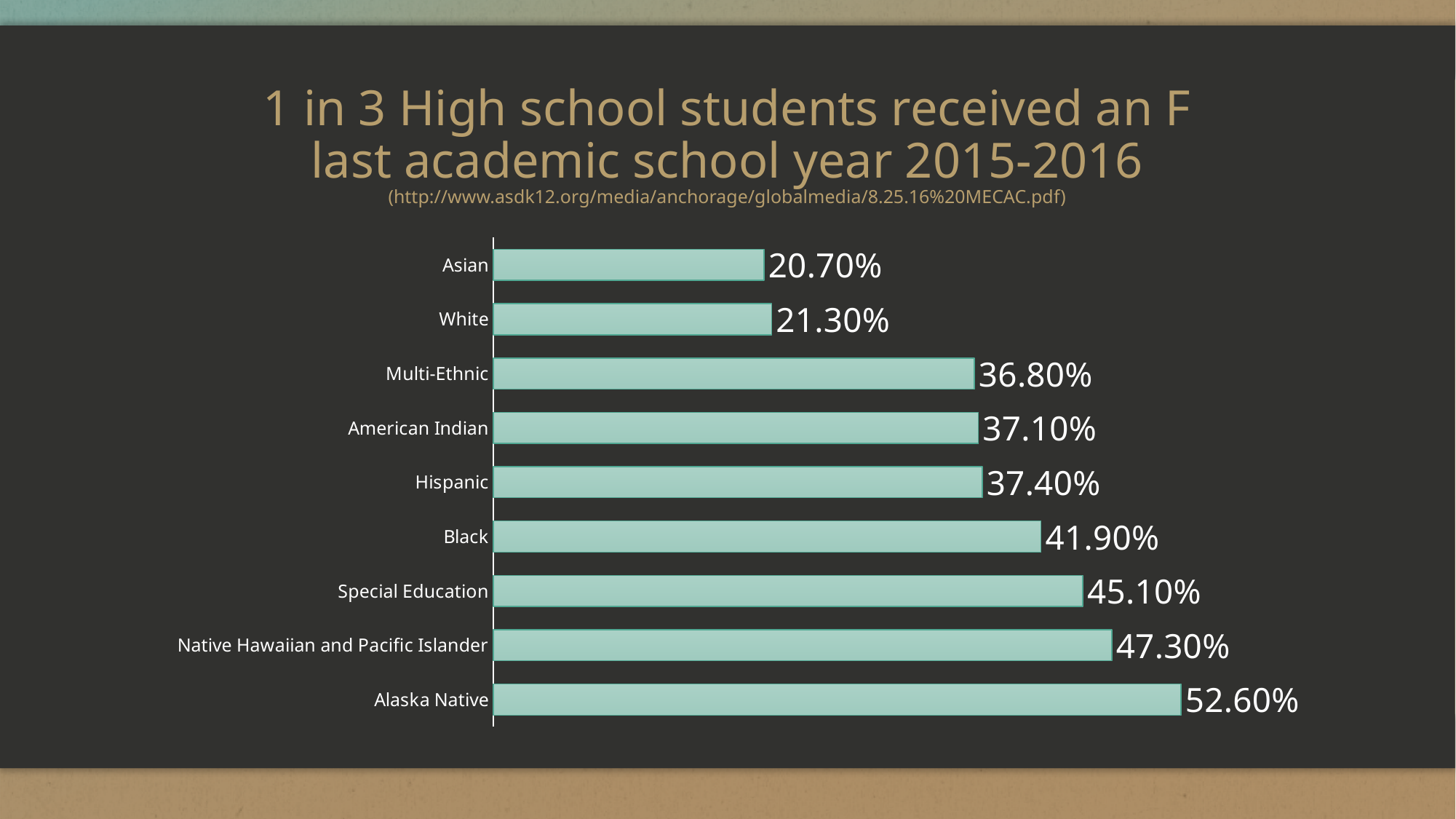
What is the title of the slide containing the chart? 1 in 3 High school students received an F last academic school year 2015-2016 What is the value for Special Education? 45.10% What is the difference between the values for Alaska Native and Asian? 31.90% How many categories are shown in the chart? 9 What kind of chart is shown on the slide? Bar chart What is the difference between the values for Black and White? 20.60% What is the value for Native Hawaiian and Pacific Islander? 47.30% Which category has the lowest value? Asian Which is larger, the value for Multi-Ethnic or the value for Special Education? Special Education Which is larger, the value for Black or the value for Hispanic? Black Which category has the highest value? Alaska Native What is the value for Asian? 20.70%